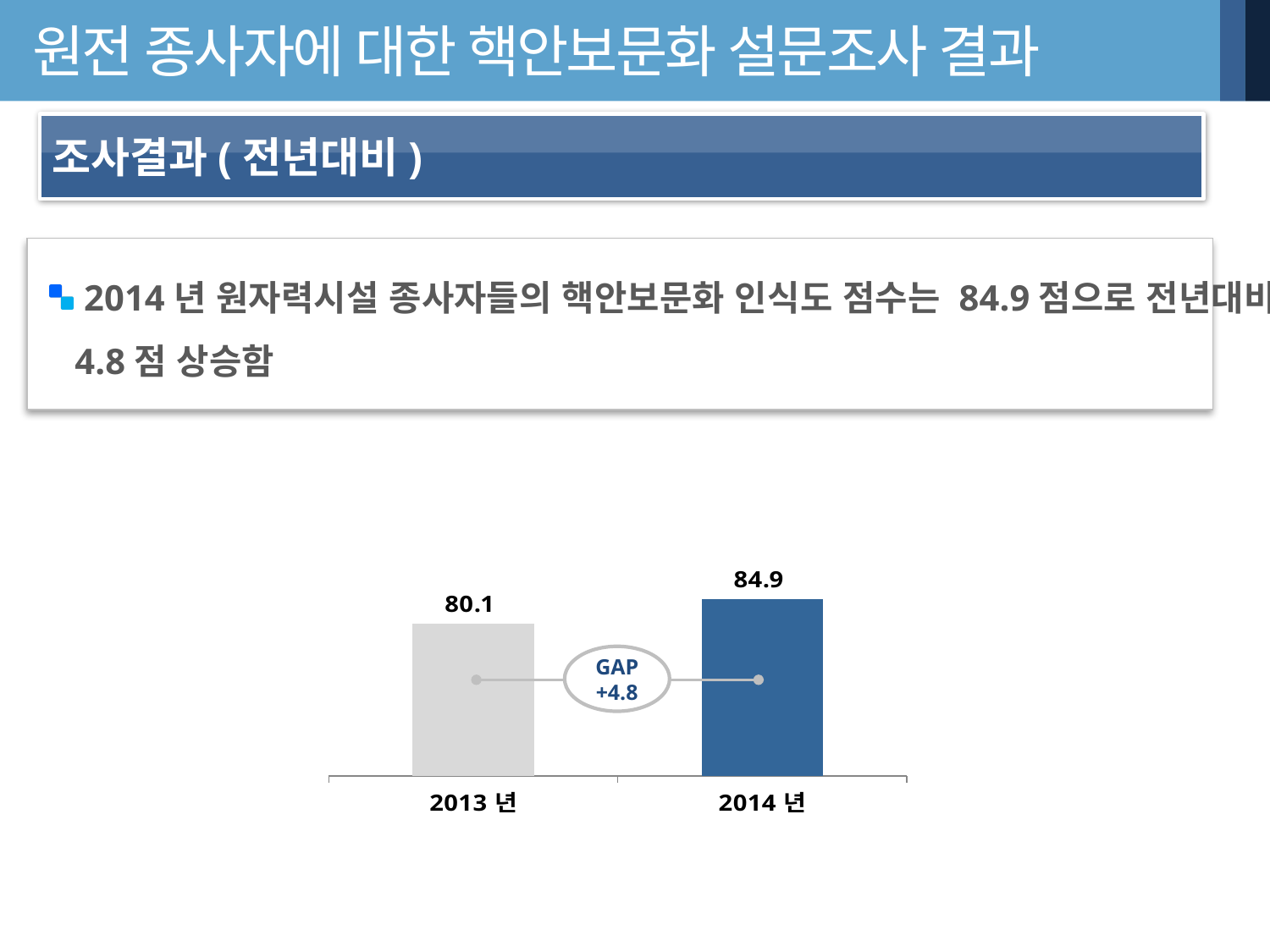
What colour is the bar for 2014 년? blue What is the difference between the values for 2014 년 and 2013 년? 4.8 What is the value for 2014 년? 84.9 Which is larger, the value for 2013 년 or the value for 2014 년? 2014 년 Do the values rise or fall from 2013 년 to 2014 년? rise What kind of chart is shown on the slide? bar chart How many categories are shown on the chart? 2 Which year has the highest value? 2014 년 What GAP value is shown between the two bars? +4.8 Which year has the lowest value? 2013 년 What is the value for 2013 년? 80.1